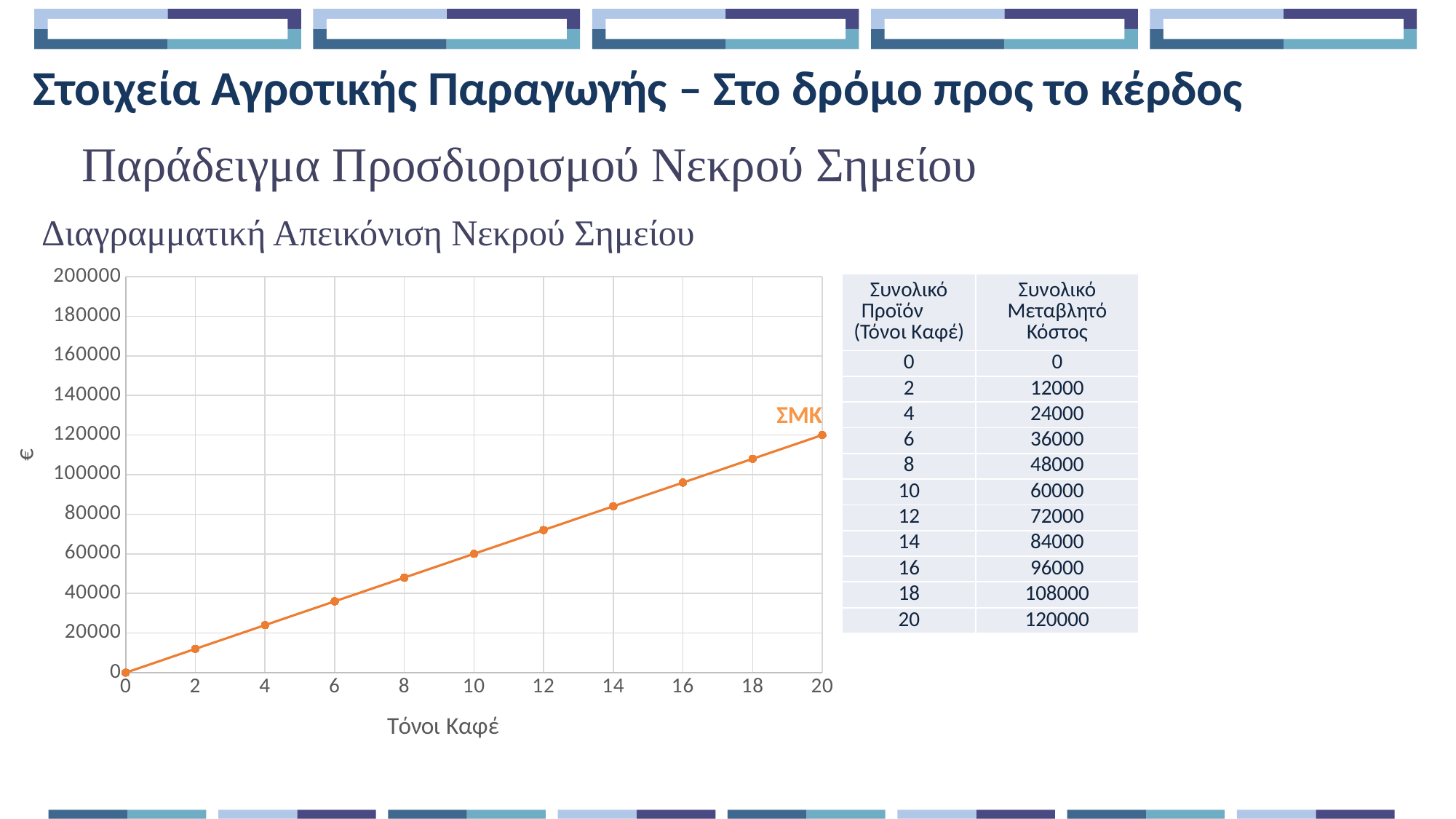
What is the total variable cost (ΣΜΚ) at 20 tons of coffee? 120000 What is the total variable cost (ΣΜΚ) at 6 tons of coffee? 36000 What kind of chart is shown on the slide? line chart Is the value for 14 tons of coffee greater or less than 80000? greater What is the label on the x axis of the line chart? Τόνοι Καφέ At which number of tons of coffee is the total variable cost (ΣΜΚ) highest? 20 At which number of tons of coffee is the total variable cost (ΣΜΚ) lowest? 0 Which is larger, the total variable cost at 16 tons or at 8 tons of coffee? 16 tons What is the total variable cost (ΣΜΚ) at 10 tons of coffee? 60000 Do the values on the line chart rise or fall as the number of tons of coffee (Τόνοι Καφέ) increases? rise What is the difference between the total variable cost at 20 tons and at 10 tons of coffee? 60000 How many data points are plotted on the line chart? 11